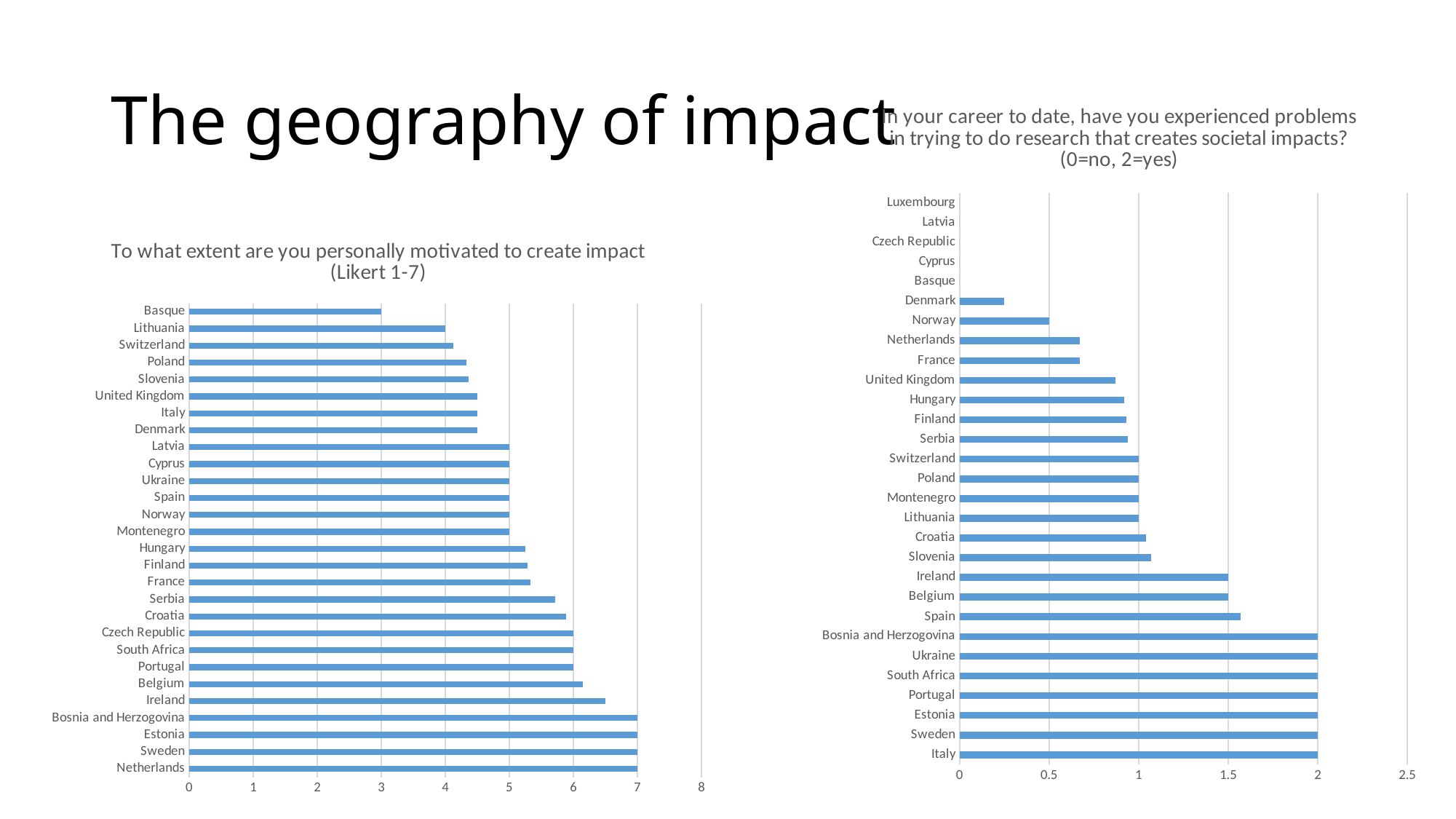
How many countries are listed in the chart 'To what extent are you personally motivated to create impact'? 28 What type of chart is the left chart on the slide? Bar chart In the chart 'To what extent are you personally motivated to create impact', what is the value for Basque? 3 In the chart 'To what extent are you personally motivated to create impact', is the value for Ireland greater or less than 6? greater In the chart 'To what extent are you personally motivated to create impact', which country has the lowest value? Basque In the right chart about experiencing problems doing research that creates societal impacts, is the value for Denmark greater or less than 0.5? less In the right chart about experiencing problems doing research that creates societal impacts, what is the value for Ireland? 1.5 In the chart 'To what extent are you personally motivated to create impact', which is larger, the value for Serbia or the value for Poland? Serbia In the right chart about experiencing problems doing research that creates societal impacts, which is larger, the value for Spain or the value for Hungary? Spain In the chart 'To what extent are you personally motivated to create impact', what is the value for Lithuania? 4 How many countries are listed in the right chart about experiencing problems doing research that creates societal impacts? 29 In the right chart about experiencing problems doing research that creates societal impacts, what is the value for Norway? 0.5